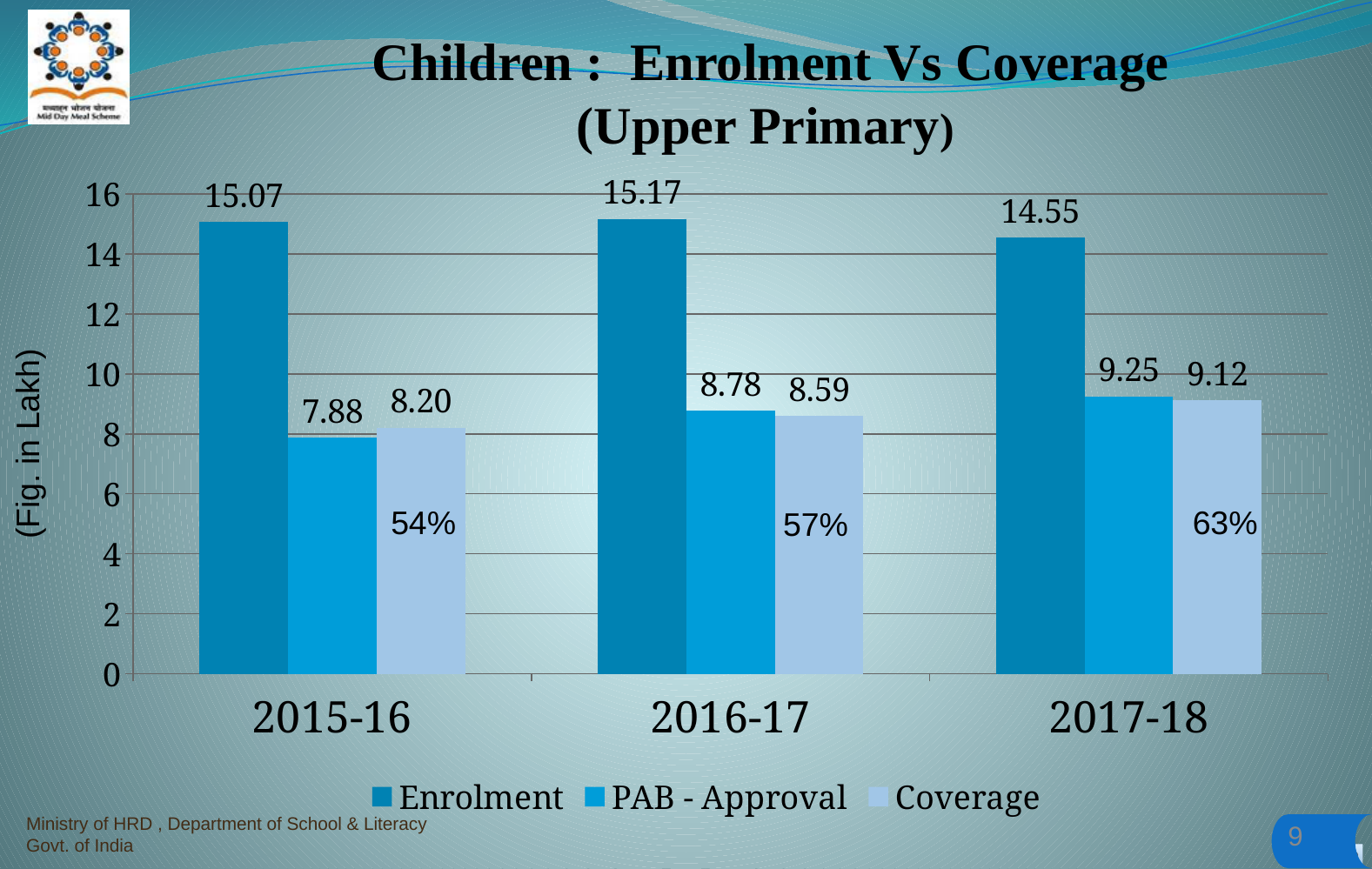
What is the PAB - Approval value for 2015-16? 7.88 How many years are shown on the x axis? 3 Which year has the lowest Coverage value? 2015-16 What is the difference between Enrolment and Coverage in 2017-18? 5.43 Which year has the highest Enrolment value? 2016-17 What is the Enrolment value for 2016-17? 15.17 What kind of chart is shown on the slide? Bar chart Which is larger in 2016-17, PAB - Approval or Coverage? PAB - Approval What percentage is printed on the Coverage bar for 2017-18? 63% What is the Coverage value for 2017-18? 9.12 How many series does the legend list? 3 Does the Coverage value rise or fall from 2015-16 to 2017-18? Rise